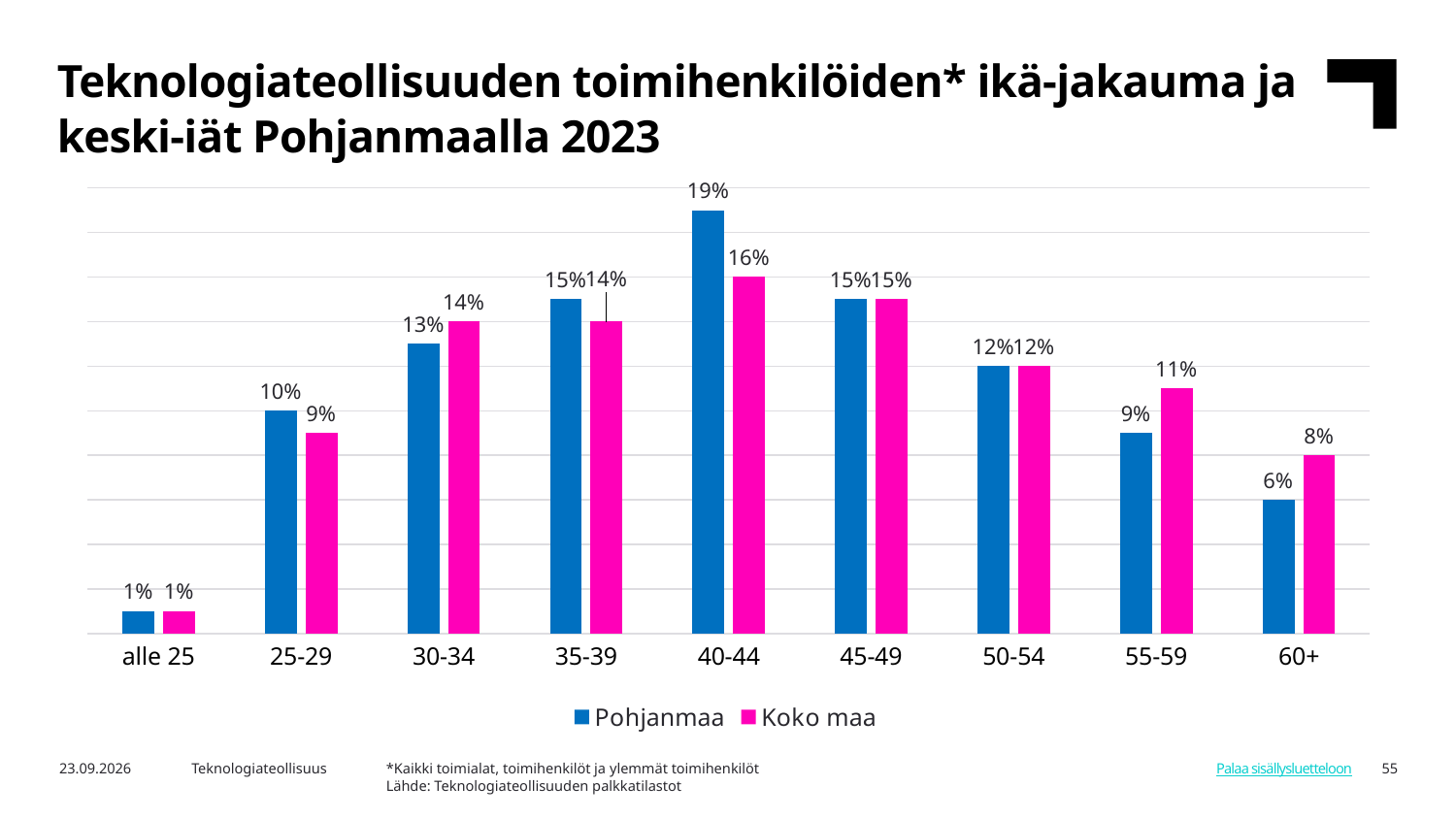
How many series does the legend list? 2 Which age group has the highest value for Pohjanmaa? 40-44 Do the Pohjanmaa values rise or fall from the 40-44 age group to the 60+ age group? Fall What is the value for Koko maa in the 60+ age group? 8% What kind of chart is shown on the slide? Bar chart Which colour represents Koko maa in the chart? Pink (magenta) Which age group has the lowest value for Koko maa? alle 25 In the 55-59 age group, which series has the larger value, Pohjanmaa or Koko maa? Koko maa What is the value for Pohjanmaa in the 25-29 age group? 10% What is the difference between the Pohjanmaa and Koko maa values in the 40-44 age group? 3% What is the value for Pohjanmaa in the 40-44 age group? 19% How many age groups are shown on the x axis? 9